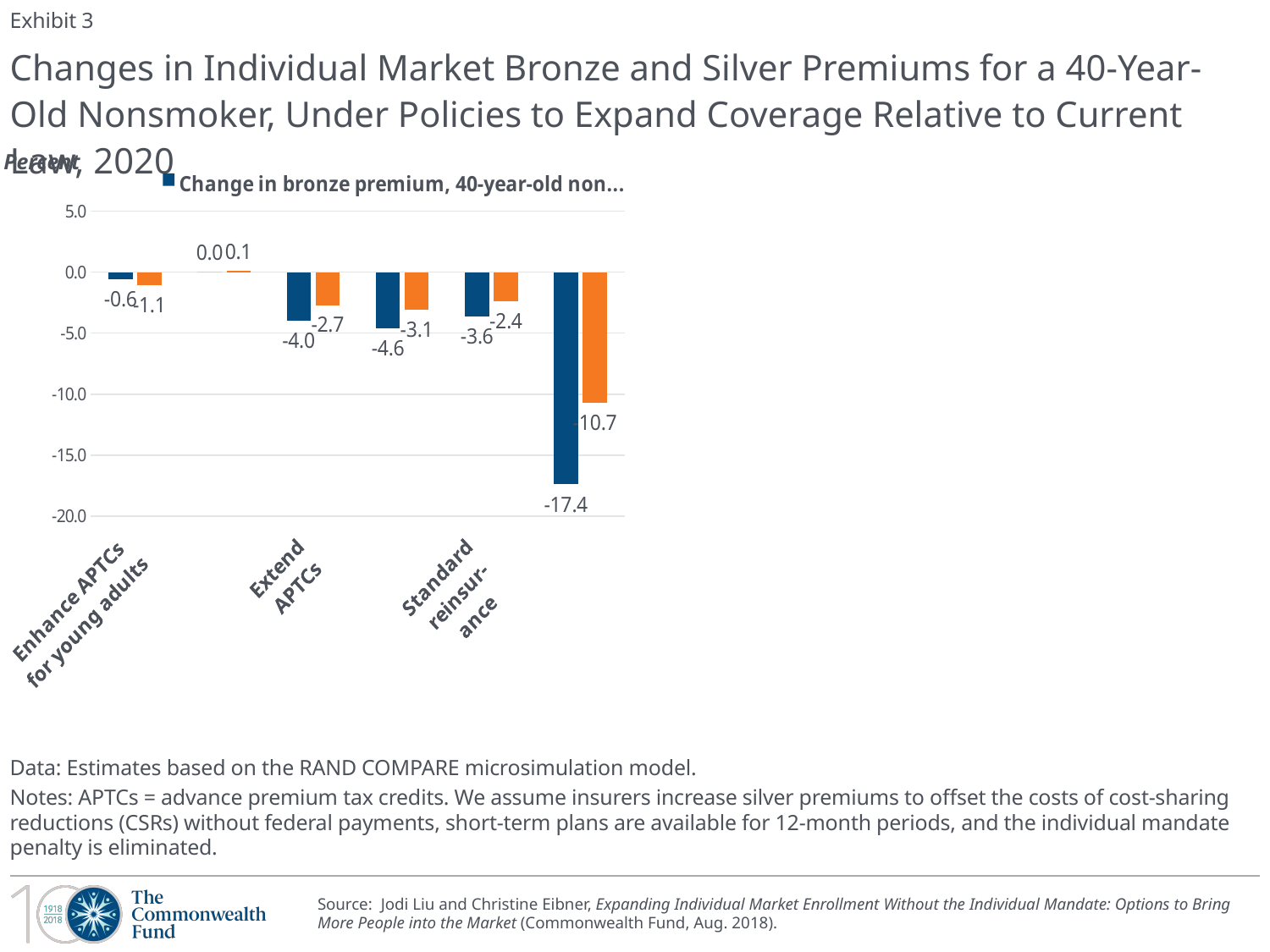
What is the lowest value labelled on the chart? -17.4 What is the value of the orange bar for Standard reinsurance? -2.4 What is the highest value labelled on the chart? 0.1 What is the unit label shown on the vertical axis of the chart? Percent What is the value of the orange bar for Enhance APTCs for young adults? -1.1 What is the value of the blue bar for Extend APTCs? -4.0 Is the value of the lowest blue bar greater or less than -15.0? less Which is larger, the blue bar for Extend APTCs or the blue bar for Standard reinsurance? Standard reinsurance What is the difference between the blue bar (-4.0) and the orange bar (-2.7) for Extend APTCs? 1.3 What kind of chart is shown on the slide? bar chart What is the value of the blue bar for Enhance APTCs for young adults? -0.6 How many groups of bars are plotted on the chart? 6